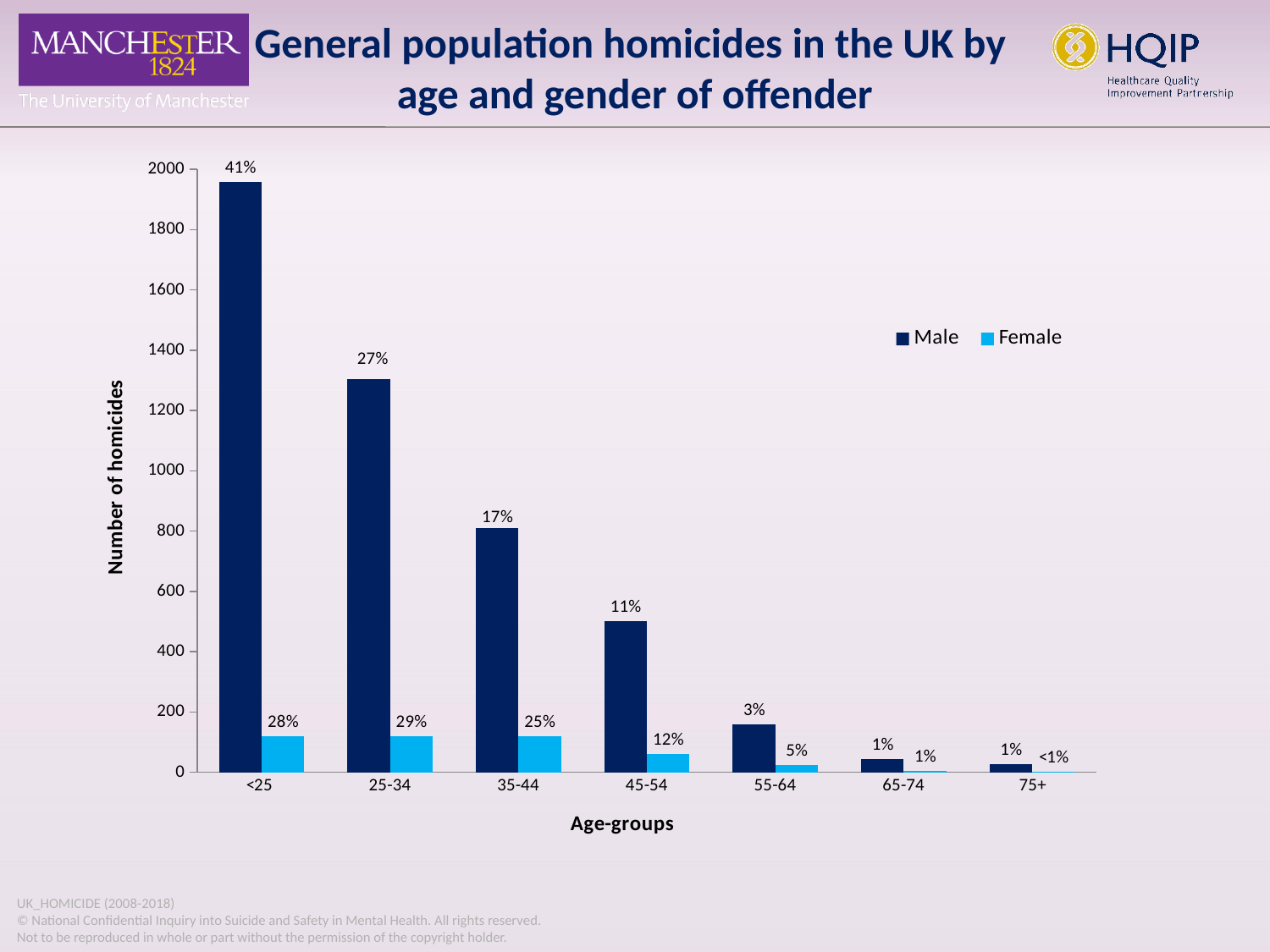
How many age groups are shown on the x axis? 7 What percentage label is shown on the Female bar for the 25-34 age group? 29% Is the number of homicides for Male offenders aged <25 greater or less than 1800? greater Is the number of homicides for Male offenders aged 45-54 greater or less than 600? less What kind of chart is shown on the slide? bar chart What percentage label is shown on the Female bar for the 75+ age group? <1% What is the label on the y axis? Number of homicides Which age group has the highest number of homicides for Male offenders? <25 For the <25 age group, which is larger: the Male bar or the Female bar? Male How many series does the legend list? 2 Do the Male bars rise or fall as the age groups increase along the x axis? fall What percentage label is shown on the Male bar for the <25 age group? 41%